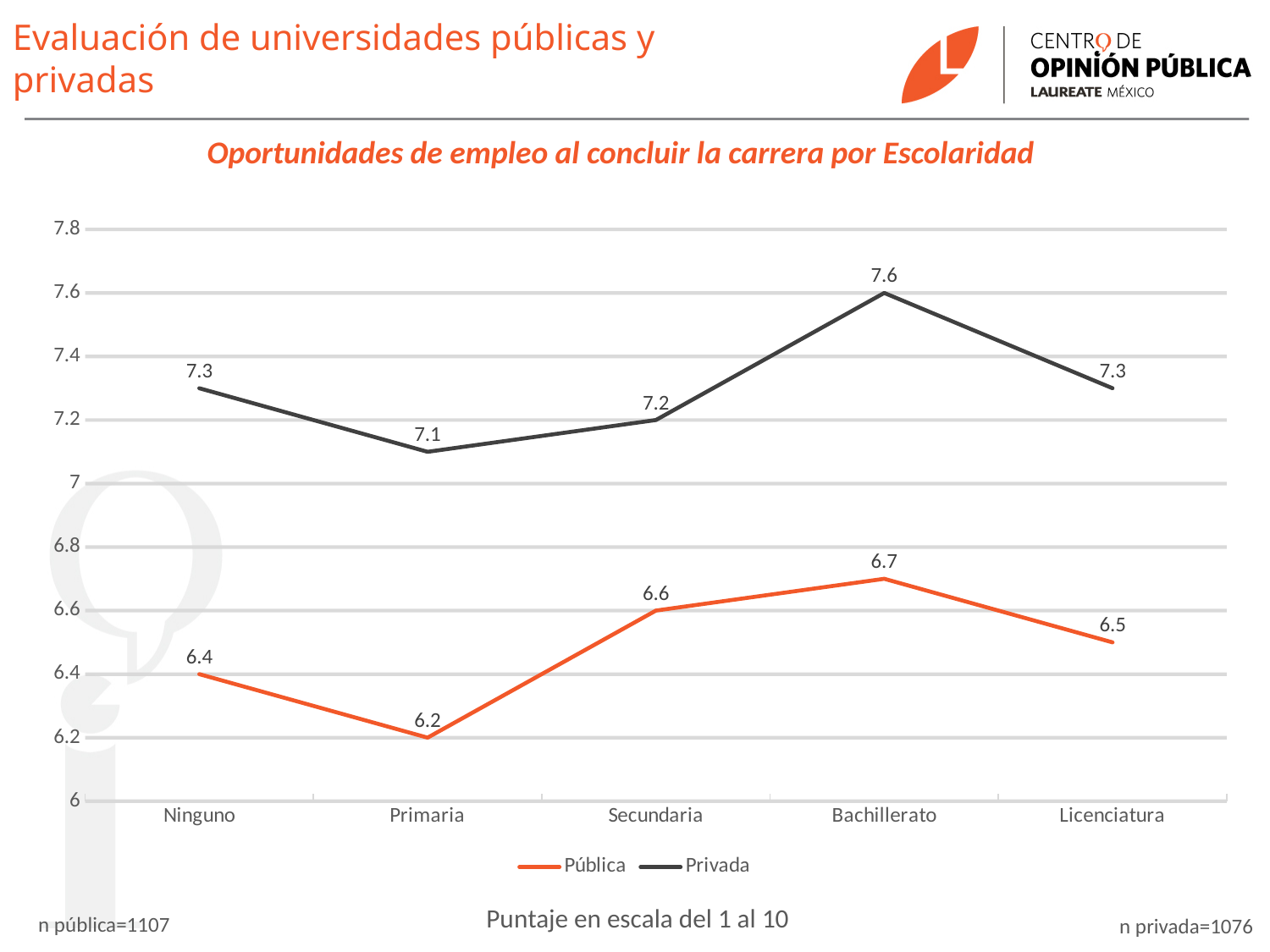
Which category has the highest value for the Pública series? Bachillerato What is the title of the chart? Oportunidades de empleo al concluir la carrera por Escolaridad How many categories are shown on the x axis? 5 Which category has the lowest value for the Privada series? Primaria What kind of chart is shown on the slide? Line chart Does the Pública series rise or fall from Primaria to Secundaria? Rise How many series does the legend list? 2 Which is larger at Ninguno, the Pública value or the Privada value? Privada What is the value for Pública at Primaria? 6.2 What is the difference between Privada and Pública at Secundaria? 0.6 What is the value for Pública at Licenciatura? 6.5 What is the value for Privada at Bachillerato? 7.6